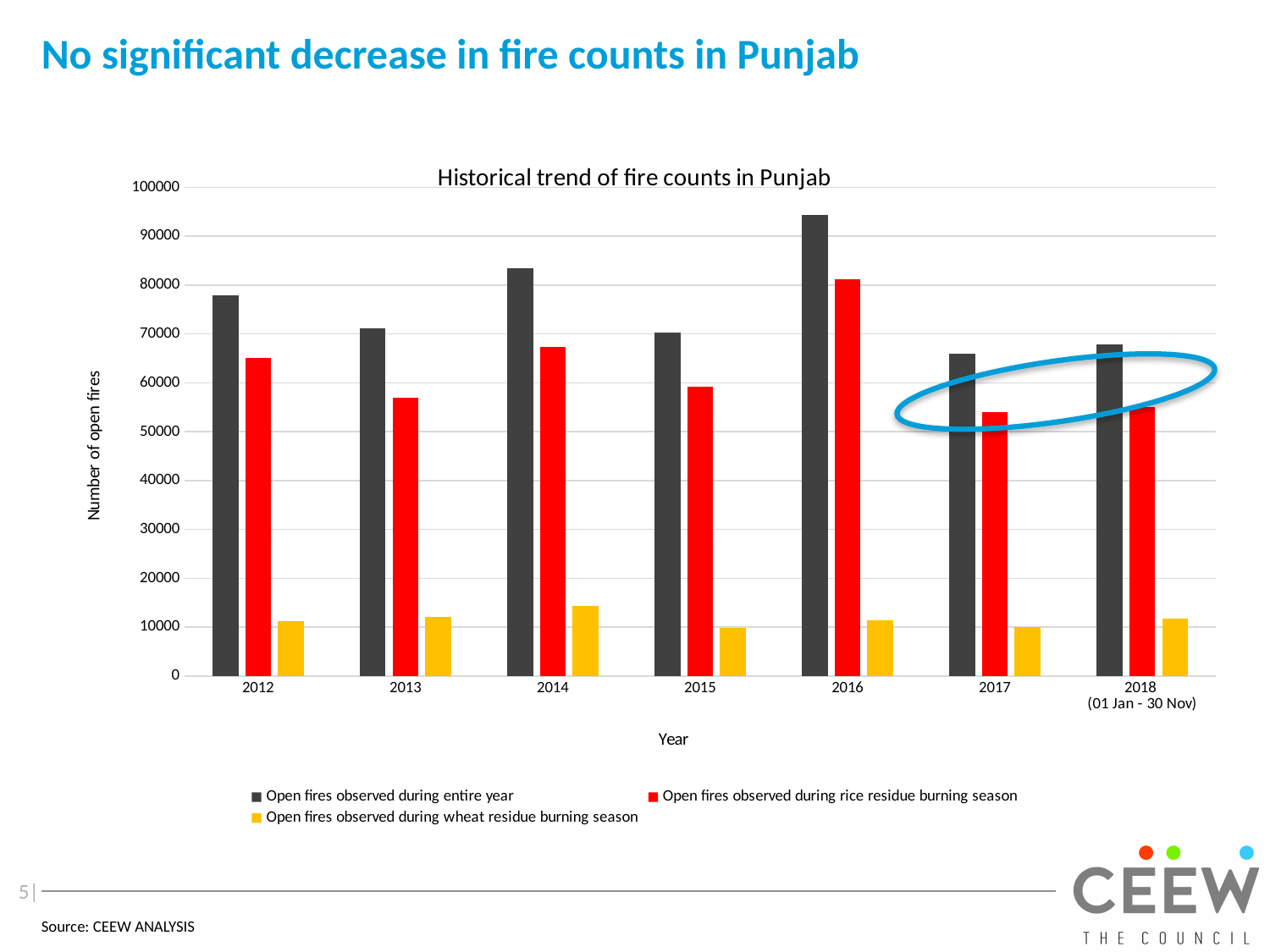
How many years are shown on the x axis? 7 Is the number of open fires observed during the entire year in 2016 greater or less than 90000? greater Which year has the highest number of open fires observed during the rice residue burning season? 2016 Is the number of open fires observed during the wheat residue burning season in 2014 greater or less than 10000? greater Which colour represents open fires observed during the wheat residue burning season? yellow How many series does the legend list? 3 What type of chart is shown on the slide? bar chart Which year had more open fires observed during the entire year, 2013 or 2014? 2014 Is the number of open fires observed during the rice residue burning season in 2017 greater or less than 50000? greater What is the title of the chart? Historical trend of fire counts in Punjab Which year has the highest number of open fires observed during the wheat residue burning season? 2014 Which year has the highest number of open fires observed during the entire year? 2016